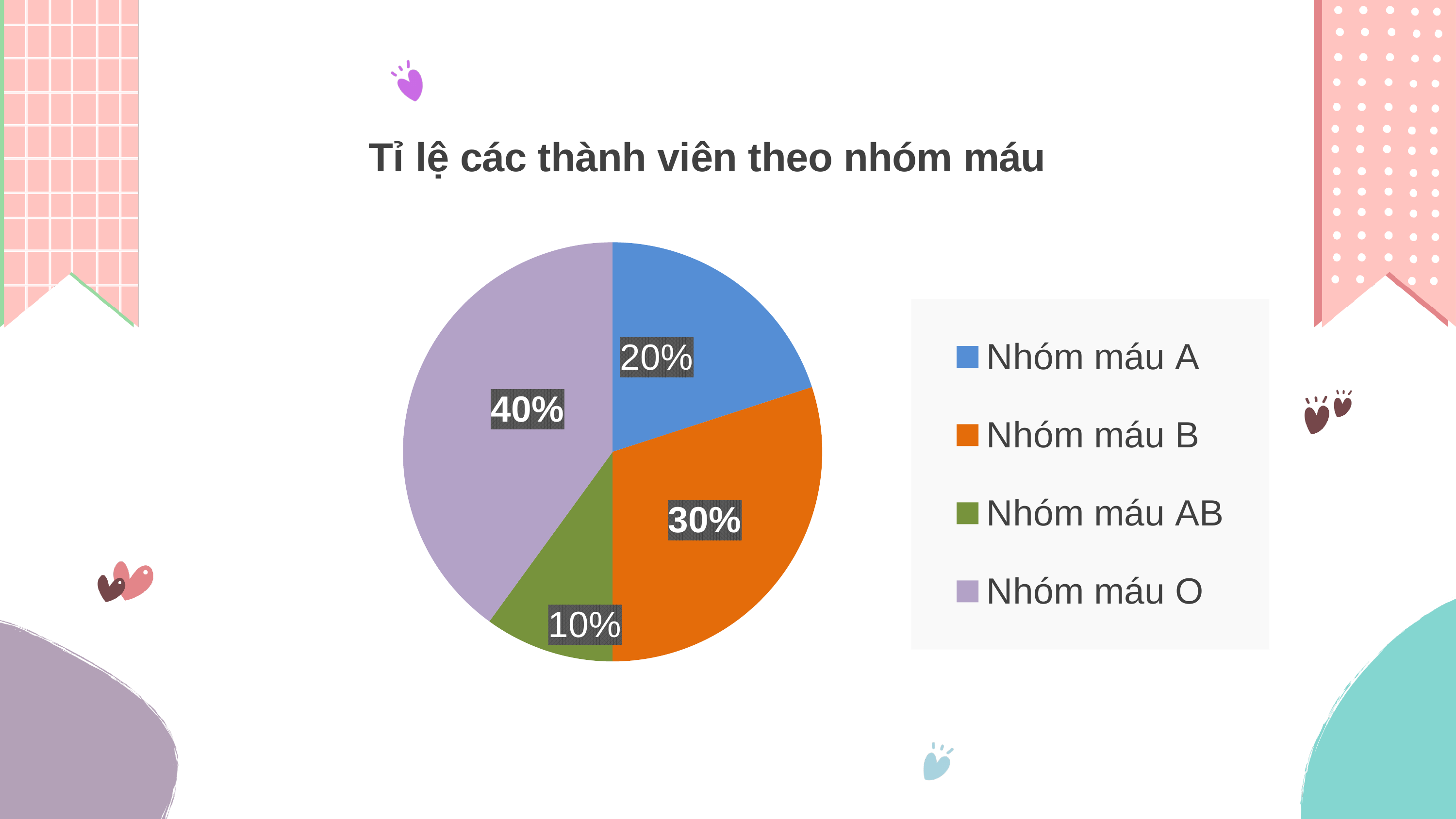
What percentage of the pie is Nhóm máu O? 40% What kind of chart is shown on the slide? pie chart Which blood group has the smallest share of the pie? Nhóm máu AB Which is larger, the share of Nhóm máu B or the share of Nhóm máu A? Nhóm máu B What percentage of the pie is Nhóm máu A? 20% How many slices does the pie chart have? 4 What is the title of the chart? Tỉ lệ các thành viên theo nhóm máu What percentage of the pie is Nhóm máu B? 30% What is the difference between the shares of Nhóm máu O and Nhóm máu A? 20% Which blood group has the largest share of the pie? Nhóm máu O What percentage of the pie is Nhóm máu AB? 10% Which colour represents Nhóm máu AB in the legend? green